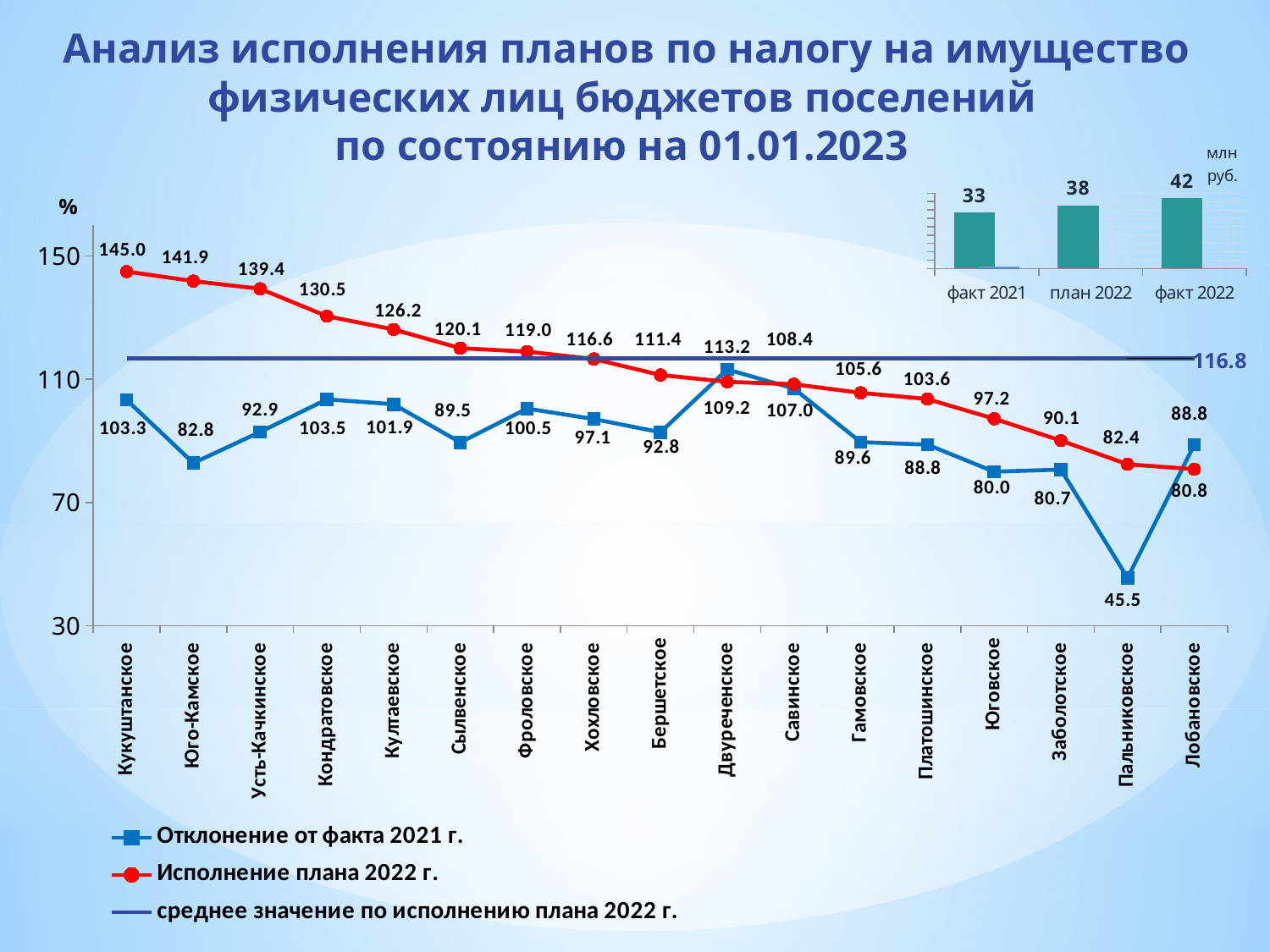
On the main line chart, how many entries does the legend list? 3 On the main line chart, what is the difference between 'Исполнение плана 2022 г.' and 'Отклонение от факта 2021 г.' for Юго-Камское? 59.1 On the main line chart, does 'Исполнение плана 2022 г.' rise or fall from left to right along the x axis? fall On the main line chart, what is the value of the line 'среднее значение по исполнению плана 2022 г.'? 116.8 On the small bar chart in the top right, what is the value for 'факт 2022'? 42 On the small bar chart in the top right, what is the difference between 'факт 2022' and 'факт 2021'? 9 On the main line chart, how many categories are shown on the x axis? 17 On the main line chart, which is larger for Двуреченское: 'Отклонение от факта 2021 г.' or 'Исполнение плана 2022 г.'? Отклонение от факта 2021 г. On the main line chart, which category has the lowest value for 'Отклонение от факта 2021 г.'? Пальниковское On the main line chart, what is the value of 'Отклонение от факта 2021 г.' for Пальниковское? 45.5 On the main line chart, what is the value of 'Исполнение плана 2022 г.' for Кукуштанское? 145.0 On the main line chart, which category has the highest value for 'Исполнение плана 2022 г.'? Кукуштанское